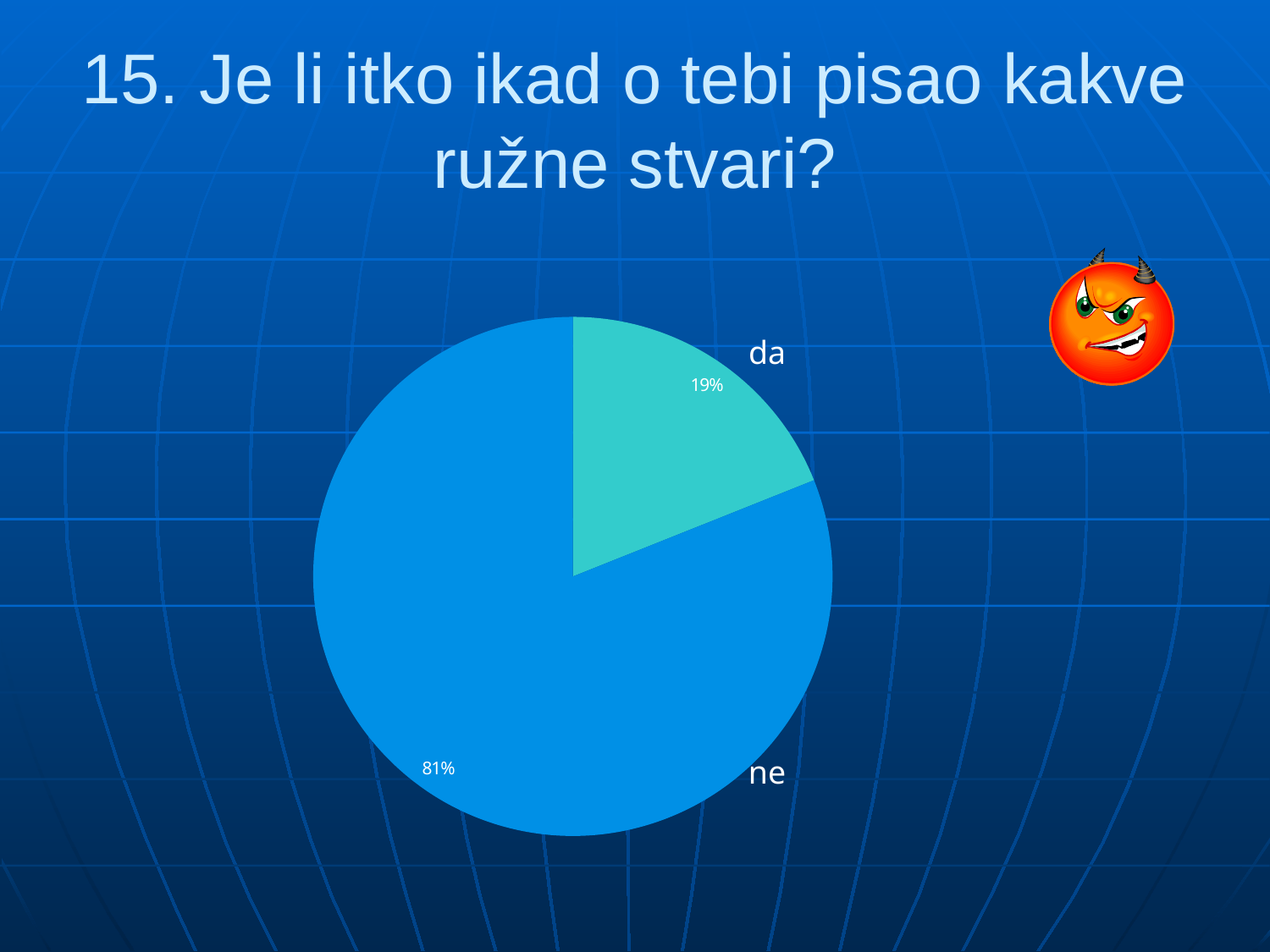
What is the difference in percentage points between the "ne" slice and the "da" slice? 62 Which slice of the pie is the largest? ne What share of the pie does the "da" slice represent? 19% What percentage of the pie is labelled "ne"? 81% What is the title of the slide containing the pie chart? 15. Je li itko ikad o tebi pisao kakve ružne stvari? Which slice of the pie is the smallest? da What colour is the "da" slice of the pie chart? teal How many slices does the pie chart have? 2 What kind of chart is shown on the slide? pie chart What percentage of the pie is labelled "da"? 19% Which slice is larger, "da" or "ne"? ne